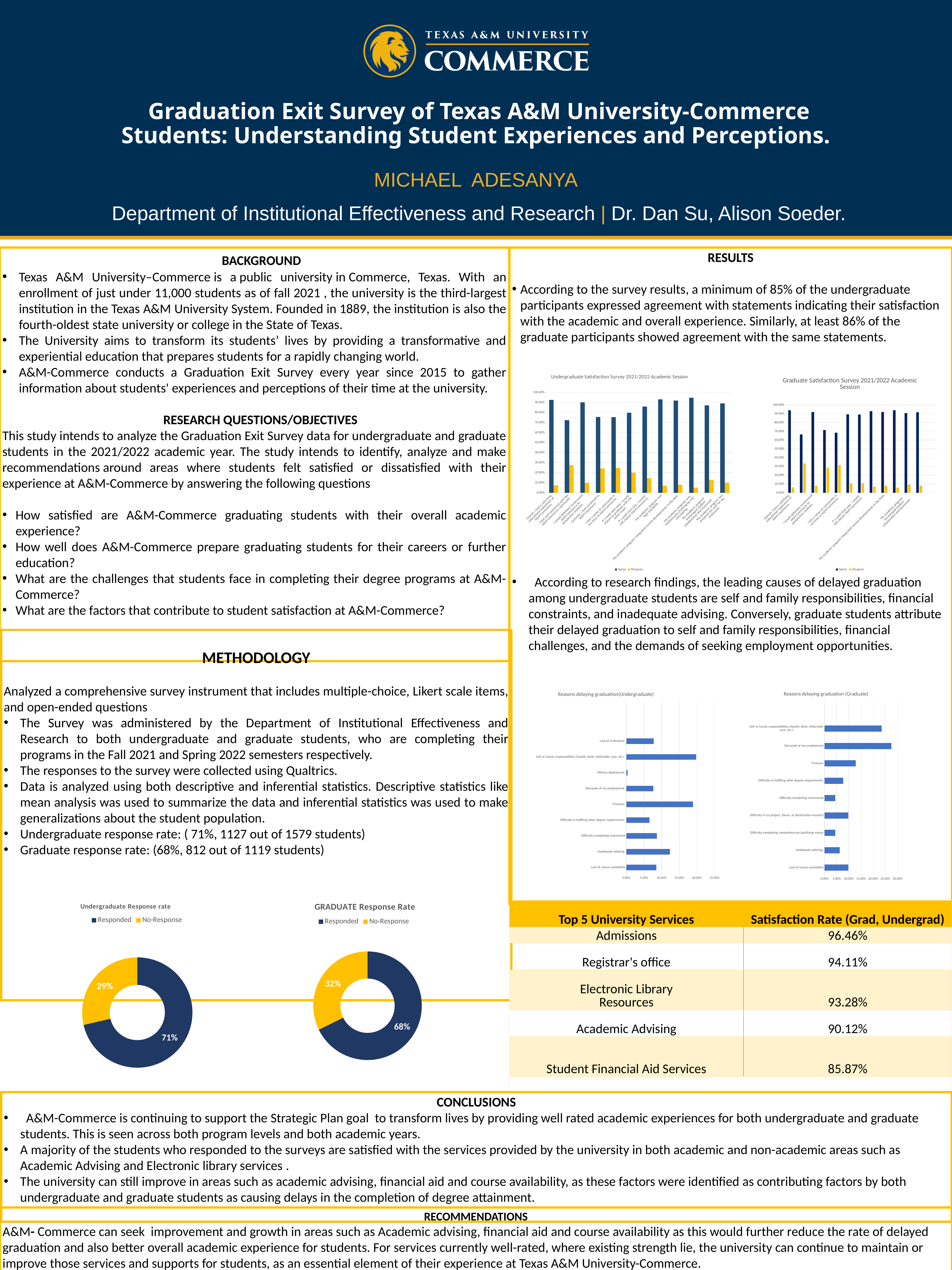
How many reasons are listed in the Reasons delaying graduation (Graduate) chart? 9 In the Reasons delaying graduation (Graduate) chart, which reason has the highest value? Demands of my employment In the GRADUATE Response Rate chart, what is the No-Response share? 32% In the Undergraduate Response rate chart, what percentage of students Responded? 71% In the GRADUATE Response Rate chart, what percentage of students Responded? 68% How many series does the legend of the Undergraduate Satisfaction Survey 2021/2022 Academic Session chart list? 2 What kind of chart is the Undergraduate Response rate chart? doughnut chart In the Reasons delaying graduation(Undergraduate) chart, is the value for Self or family responsibilities greater or less than 15.00%? greater In the Reasons delaying graduation(Undergraduate) chart, which is larger: Finances or Lack of motivation? Finances In the Reasons delaying graduation(Undergraduate) chart, which reason has the lowest value? Military deployment In the Undergraduate Response rate chart, what is the No-Response share? 29%